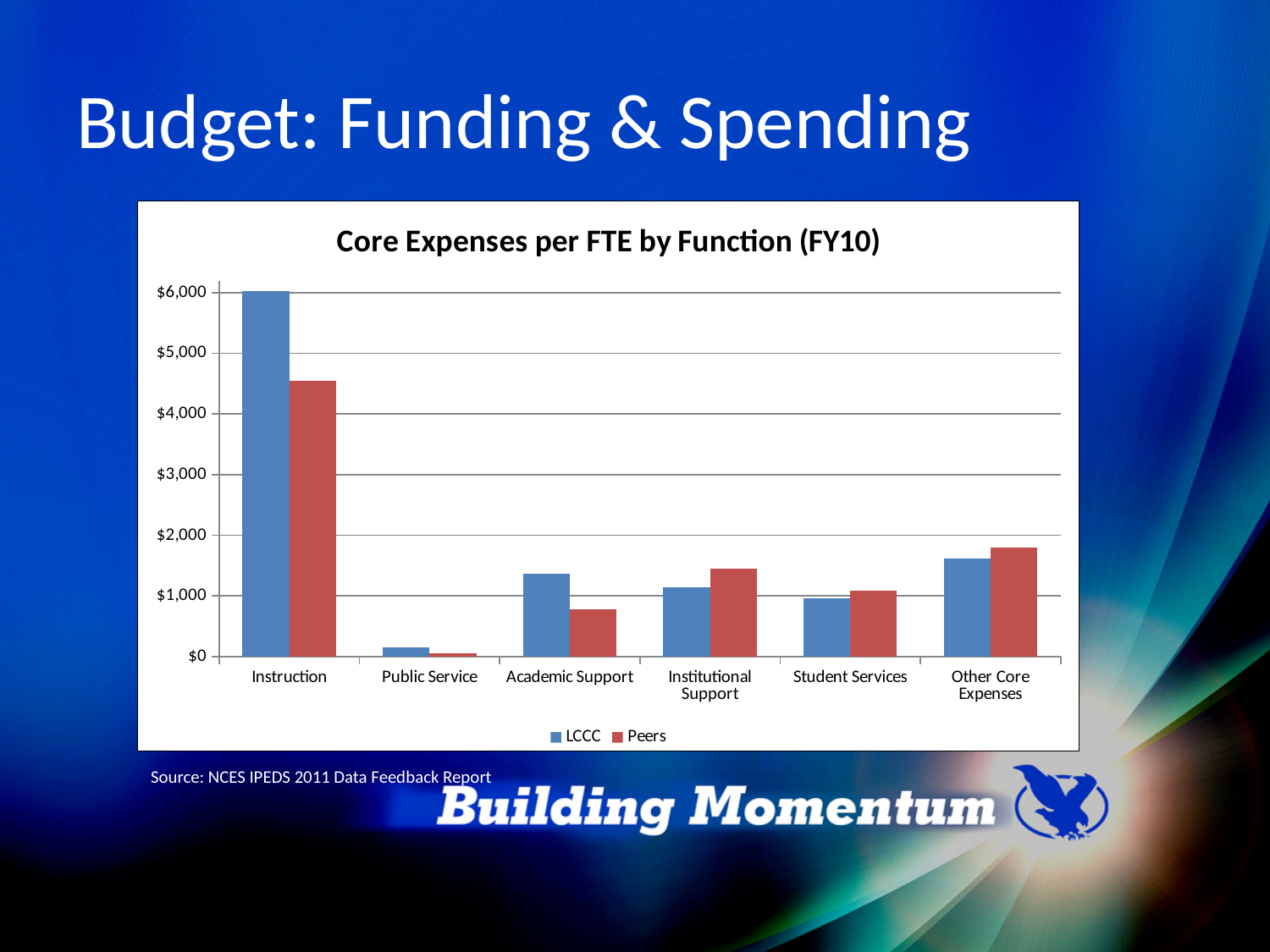
For Academic Support, which is larger, LCCC or Peers? LCCC How many series does the legend list? 2 Is the Peers value for Academic Support greater or less than $1,000? less What type of chart is shown on the slide? Bar chart Is the Peers value for Other Core Expenses greater or less than $2,000? less For Institutional Support, which is larger, LCCC or Peers? Peers Which function has the highest LCCC value? Instruction How many function categories are shown on the x axis? 6 What is the title of the chart? Core Expenses per FTE by Function (FY10) Is the Peers value for Instruction greater or less than $5,000? less For Instruction, which is larger, LCCC or Peers? LCCC Which function has the lowest Peers value? Public Service